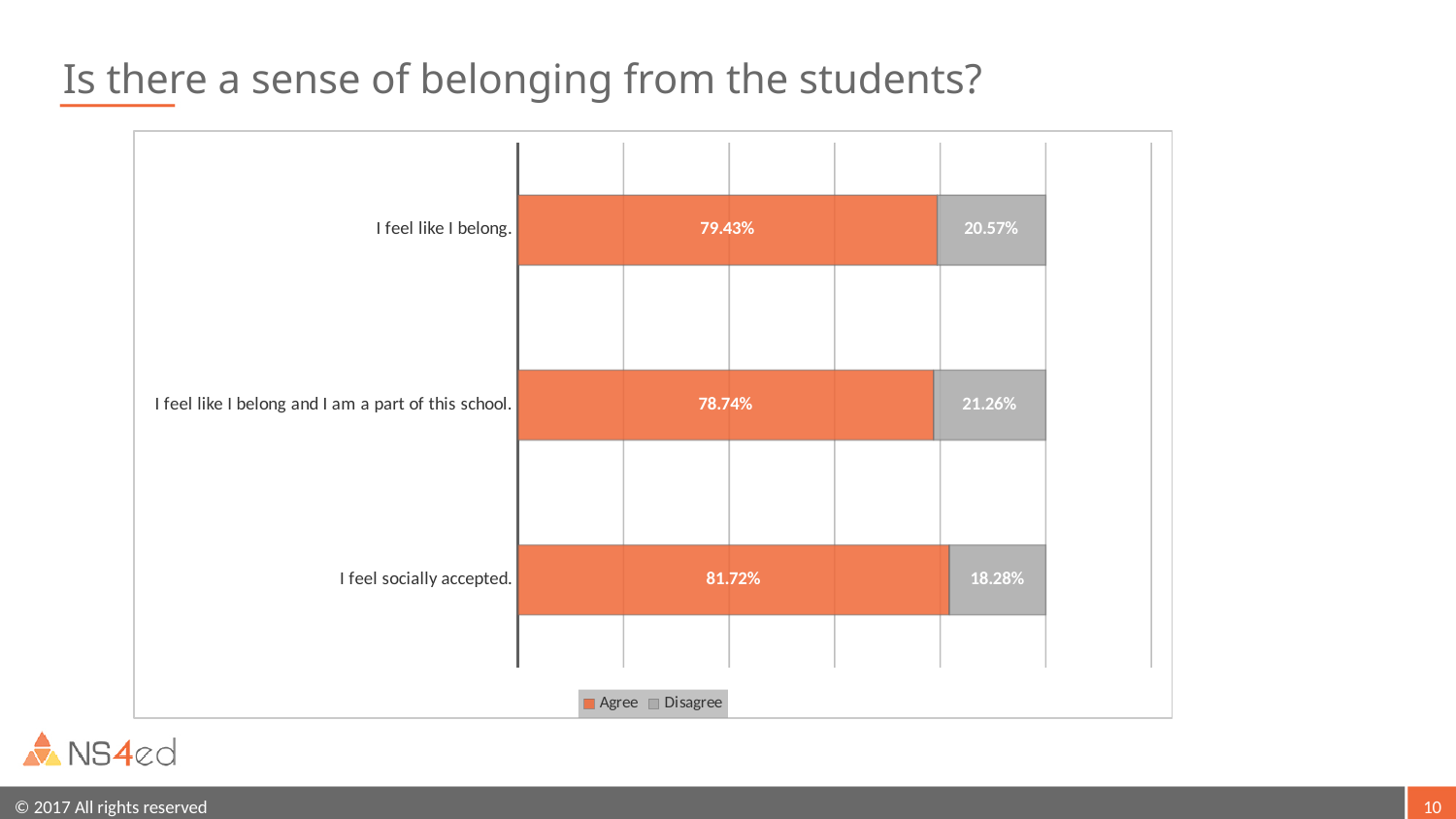
What is the difference between the Agree values for "I feel socially accepted." and "I feel like I belong."? 2.29% What kind of chart is shown on the slide? Stacked bar chart What is the Agree value for "I feel like I belong."? 79.43% What is the Disagree value for "I feel like I belong and I am a part of this school."? 21.26% Which statement has the highest Agree percentage? I feel socially accepted. Which statement has the lowest Agree percentage? I feel like I belong and I am a part of this school. How many statements are shown in the chart? 3 Which colour represents the Agree series in the chart? Orange Is the Disagree value larger for "I feel like I belong." or for "I feel socially accepted."? I feel like I belong. What percentage of students agree with "I feel socially accepted."? 81.72% How many series does the legend list? 2 Which statement has the highest Disagree percentage? I feel like I belong and I am a part of this school.